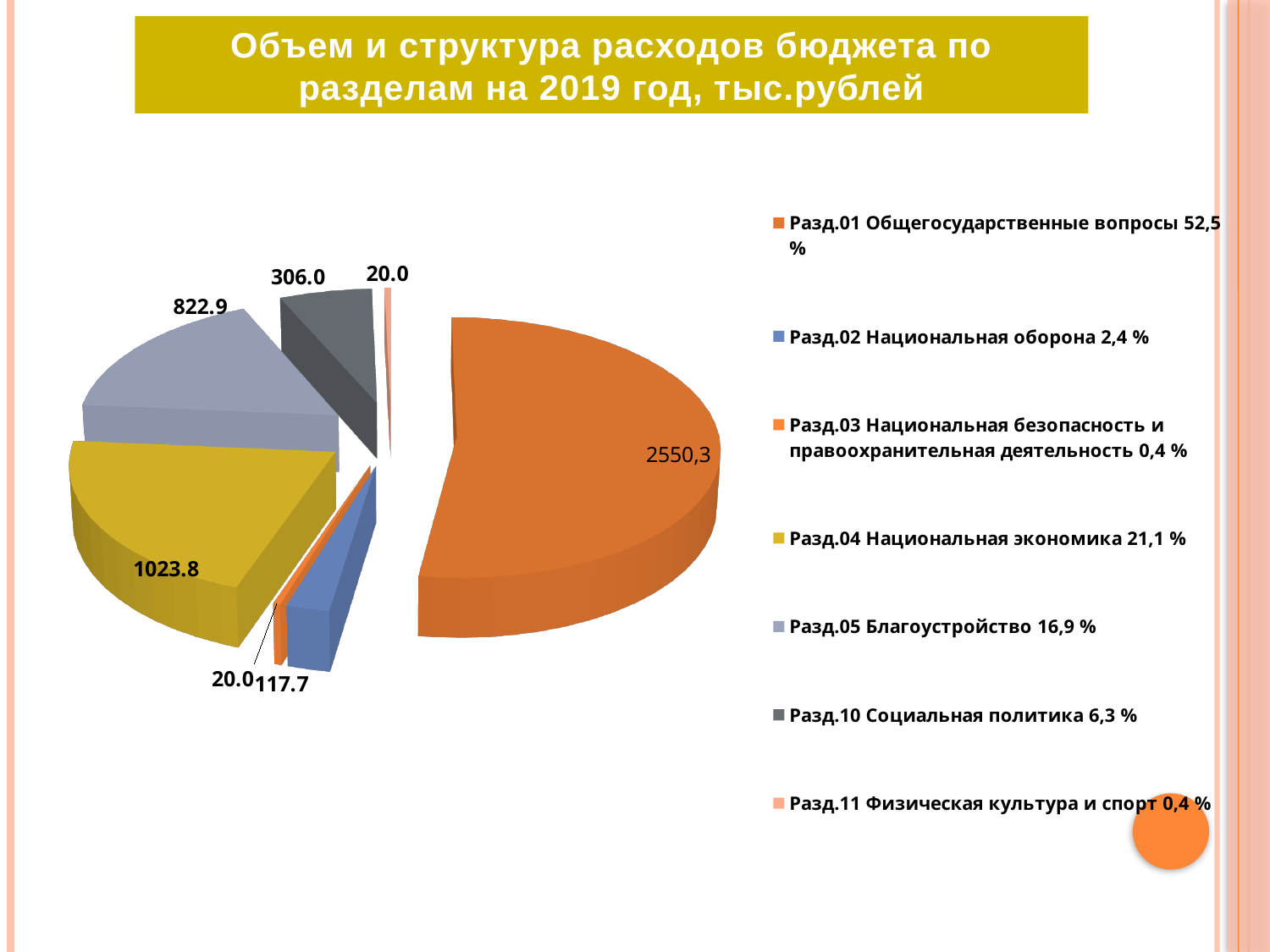
What is the value for Разд.02 Национальная оборона? 117.7 What share of the pie does Разд.04 Национальная экономика represent, according to the legend? 21,1 % Which section has the largest slice of the pie? Разд.01 Общегосударственные вопросы What is the value for Разд.01 Общегосударственные вопросы? 2550,3 What is the difference between the values for Разд.04 Национальная экономика and Разд.05 Благоустройство? 200.9 Which is larger: the value for Разд.10 Социальная политика or Разд.02 Национальная оборона? Разд.10 Социальная политика What is the value for Разд.05 Благоустройство? 822.9 What share of the pie does Разд.05 Благоустройство represent, according to the legend? 16,9 % How many sections are listed in the legend? 7 What is the value for Разд.04 Национальная экономика? 1023.8 What is the value for Разд.10 Социальная политика? 306.0 What kind of chart is shown on the slide? pie chart